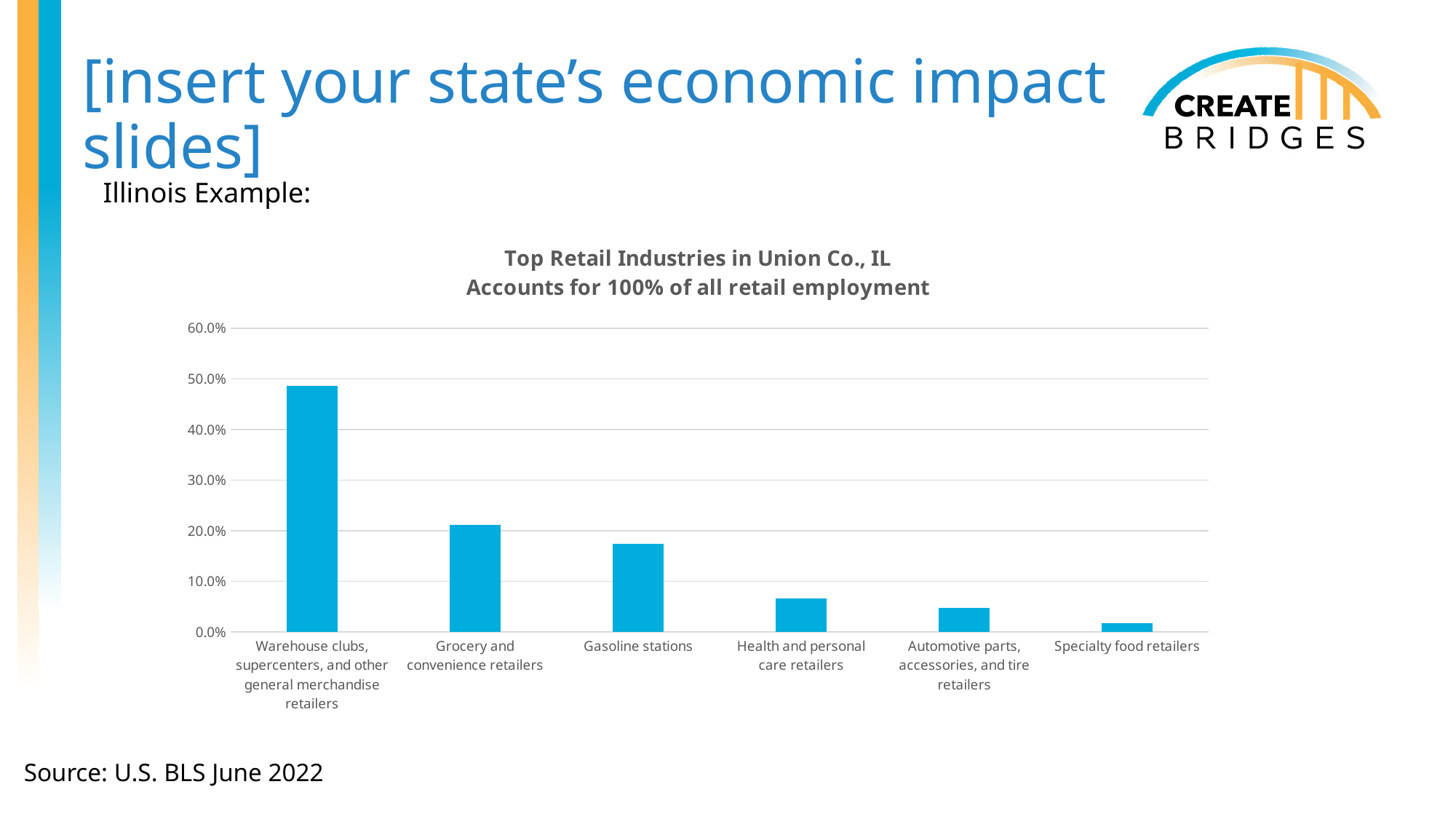
Which is larger, the value for Grocery and convenience retailers or the value for Gasoline stations? Grocery and convenience retailers Is the value for Gasoline stations greater or less than 10.0%? greater Which retail industry has the lowest share of retail employment in the chart? Specialty food retailers Do the bar values rise or fall moving from left to right along the x axis? fall Is the value for Health and personal care retailers greater or less than 10.0%? less Which is larger, the value for Automotive parts, accessories, and tire retailers or the value for Specialty food retailers? Automotive parts, accessories, and tire retailers What kind of chart is shown on the slide? bar chart How many retail industry categories are plotted in the chart? 6 Is the value for Grocery and convenience retailers greater or less than 30.0%? less Which retail industry has the highest share of retail employment in the chart? Warehouse clubs, supercenters, and other general merchandise retailers What is the title of the chart? Top Retail Industries in Union Co., IL Accounts for 100% of all retail employment